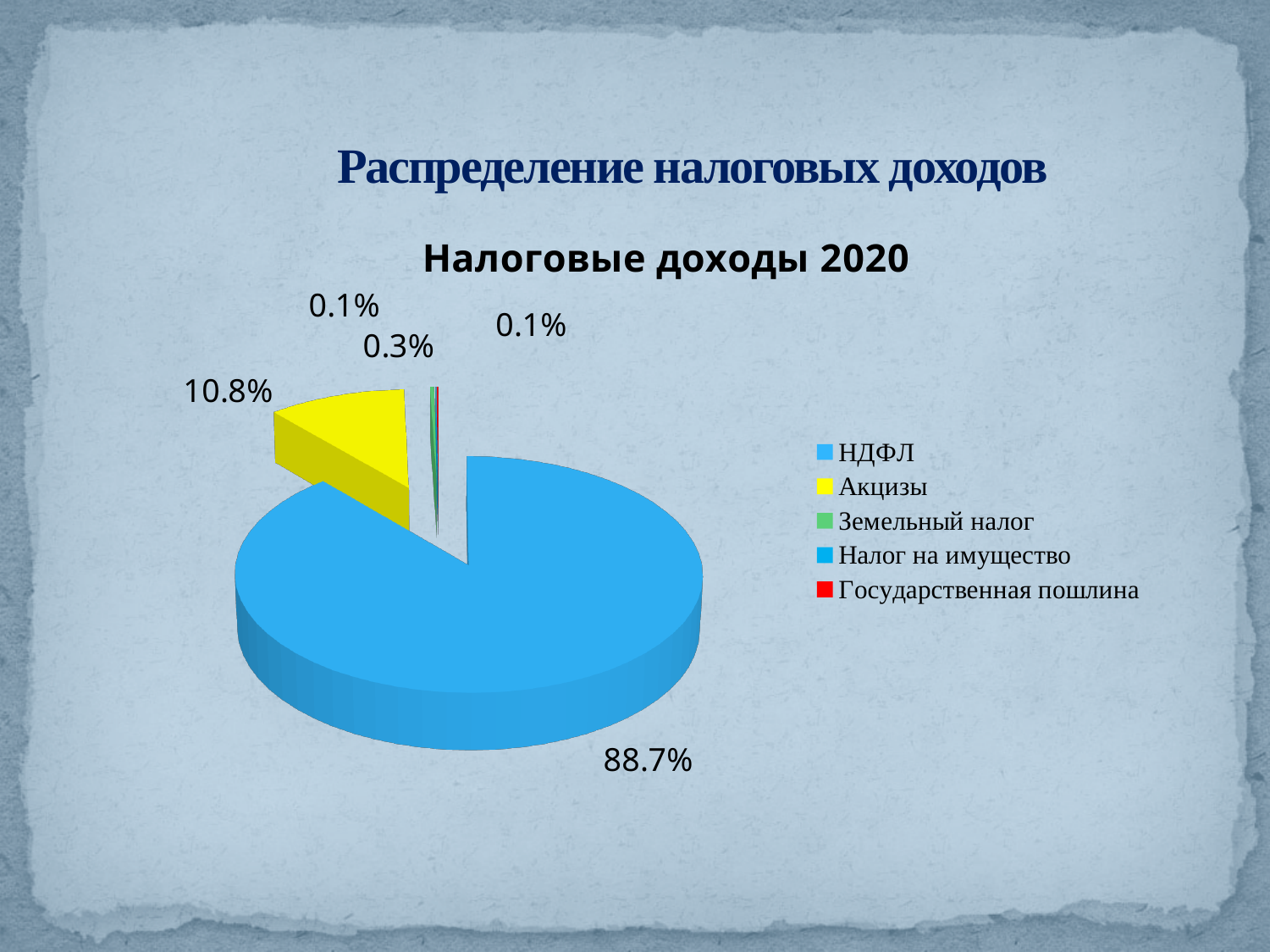
What is the title of the chart? Налоговые доходы 2020 Which is larger, the share for НДФЛ or the share for Акцизы? НДФЛ What is the largest percentage label shown on the chart? 88.7% What colour is used for Акцизы in the chart? Yellow What is the difference in percentage points between the share for НДФЛ and the share for Акцизы? 77.9 How many categories does the legend list? 5 Which category has the largest share of the pie? НДФЛ What share of the pie does Акцизы have? 10.8% What share of the pie does НДФЛ have? 88.7% What kind of chart is shown on the slide? Pie chart